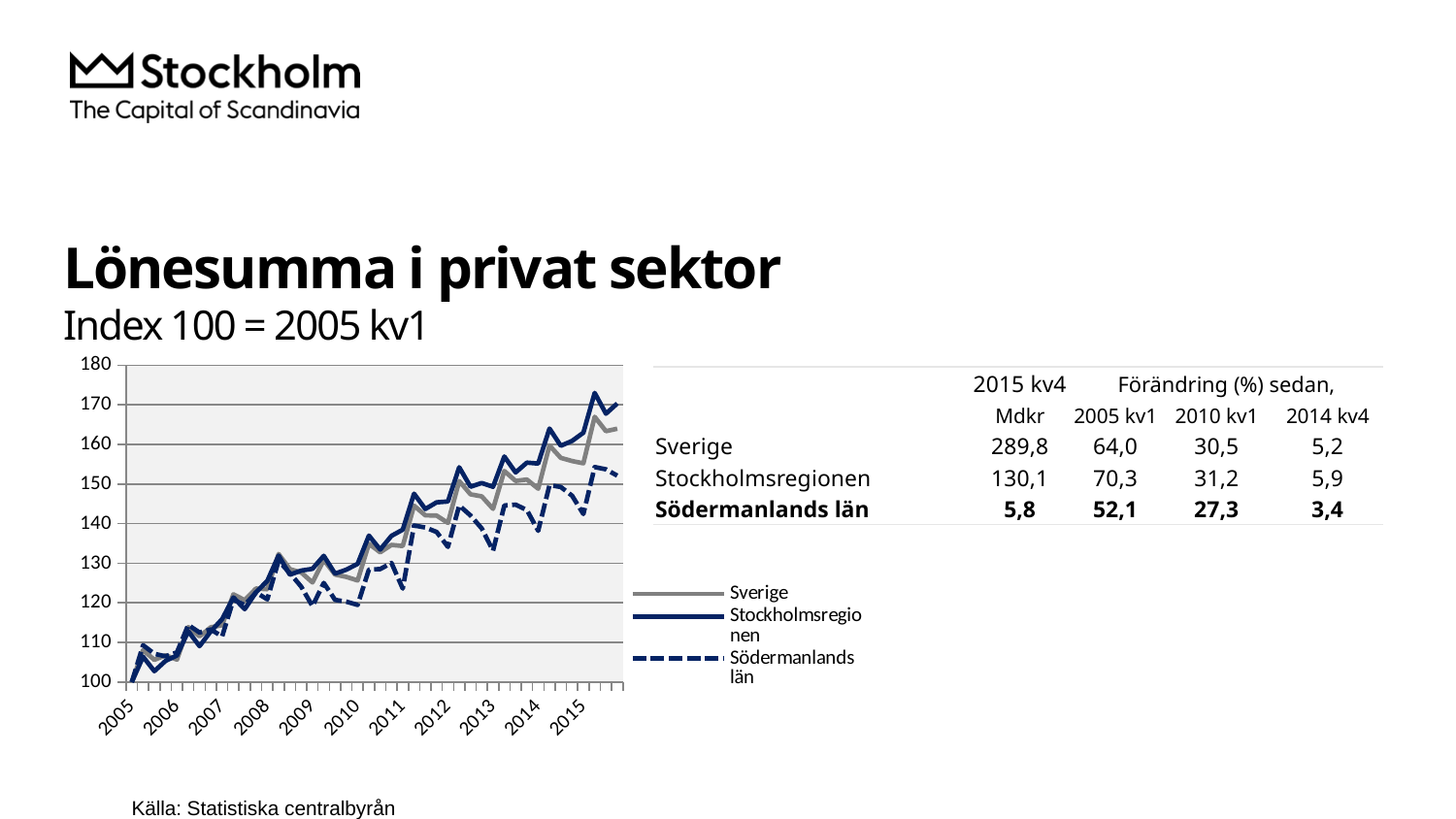
Do the index values in the chart generally rise or fall from 2005 to 2015? rise What kind of chart is shown on the slide? line chart Which series has the lowest index value at the end of the chart in 2015? Södermanlands län At the end of the chart in 2015, is the index for Stockholmsregionen greater or less than 160? greater At the end of the chart in 2015, which series is higher: Stockholmsregionen or Sverige? Stockholmsregionen Which series in the chart is drawn with a dashed line? Södermanlands län How many year labels are shown on the x axis of the chart? 11 What is the title of the chart on the slide? Lönesumma i privat sektor What is the index value of all three series at 2005 kv1, the base period of the chart? 100 Which series has the highest index value at the end of the chart in 2015? Stockholmsregionen How many series does the chart's legend list? 3 At the end of the chart in 2015, is the index for Södermanlands län greater or less than 140? greater